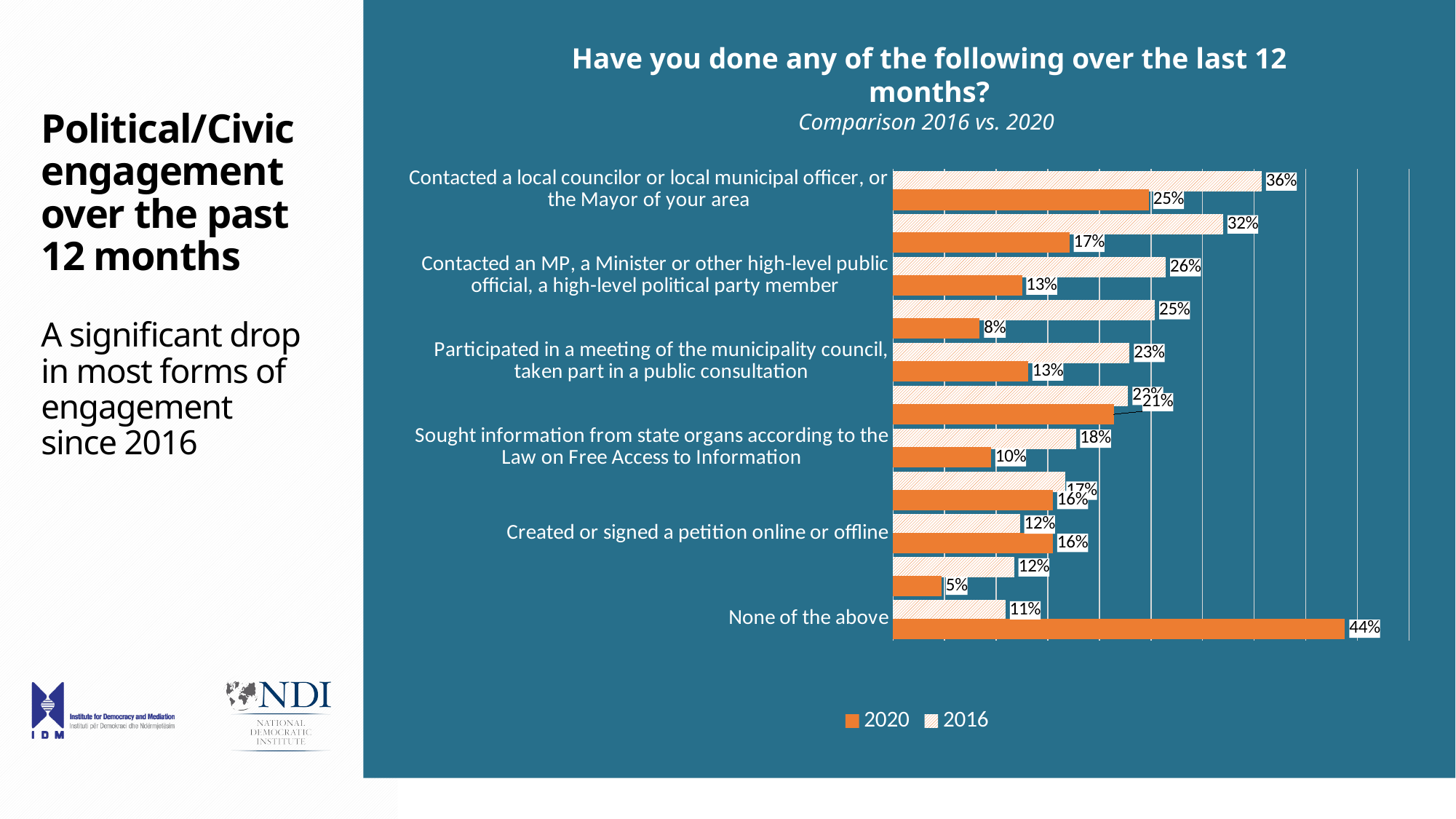
What is the 2020 value for "Sought information from state organs according to the Law on Free Access to Information"? 10% What is the 2016 value for "Participated in a meeting of the municipality council, taken part in a public consultation"? 23% By how many percentage points did "Contacted an MP, a Minister or other high-level public official, a high-level political party member" fall from 2016 to 2020? 13 percentage points What kind of chart is shown on the slide? Bar chart How many series does the legend list? 2 Which colour represents the 2020 series in the legend? Orange Which category has the highest 2020 value? None of the above What is the 2020 value for "Contacted a local councilor or local municipal officer, or the Mayor of your area"? 25% What is the 2016 value for "None of the above"? 11% What is the 2016 value for "Contacted a local councilor or local municipal officer, or the Mayor of your area"? 36% For "Created or signed a petition online or offline", which year has the larger value, 2016 or 2020? 2020 What is the 2020 value for "None of the above"? 44%